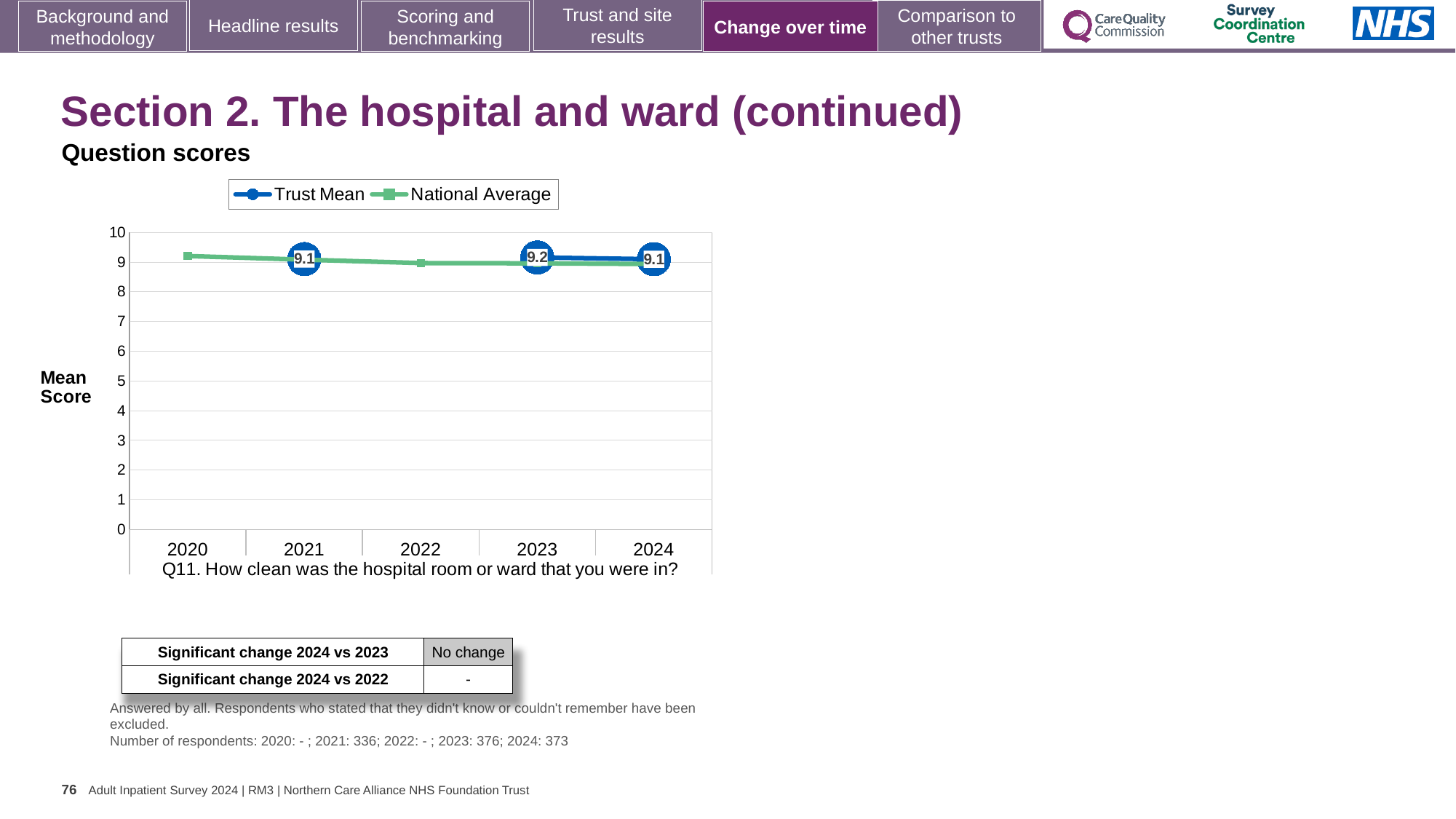
Which is larger, the Trust Mean for 2023 or for 2021? 2023 What is the Trust Mean value for 2021? 9.1 What is the Trust Mean value for 2024? 9.1 What kind of chart is shown on the slide? Line chart How many series does the legend list? 2 How many years are shown on the x axis of the chart? 5 What is the Trust Mean value for 2023? 9.2 What is the difference between the Trust Mean in 2023 and in 2024? 0.1 In which year is the labelled Trust Mean highest? 2023 Which survey question does the chart show scores for? Q11. How clean was the hospital room or ward that you were in? Is the National Average value for 2020 greater or less than 8? greater Is the National Average value for 2022 greater or less than 5? greater